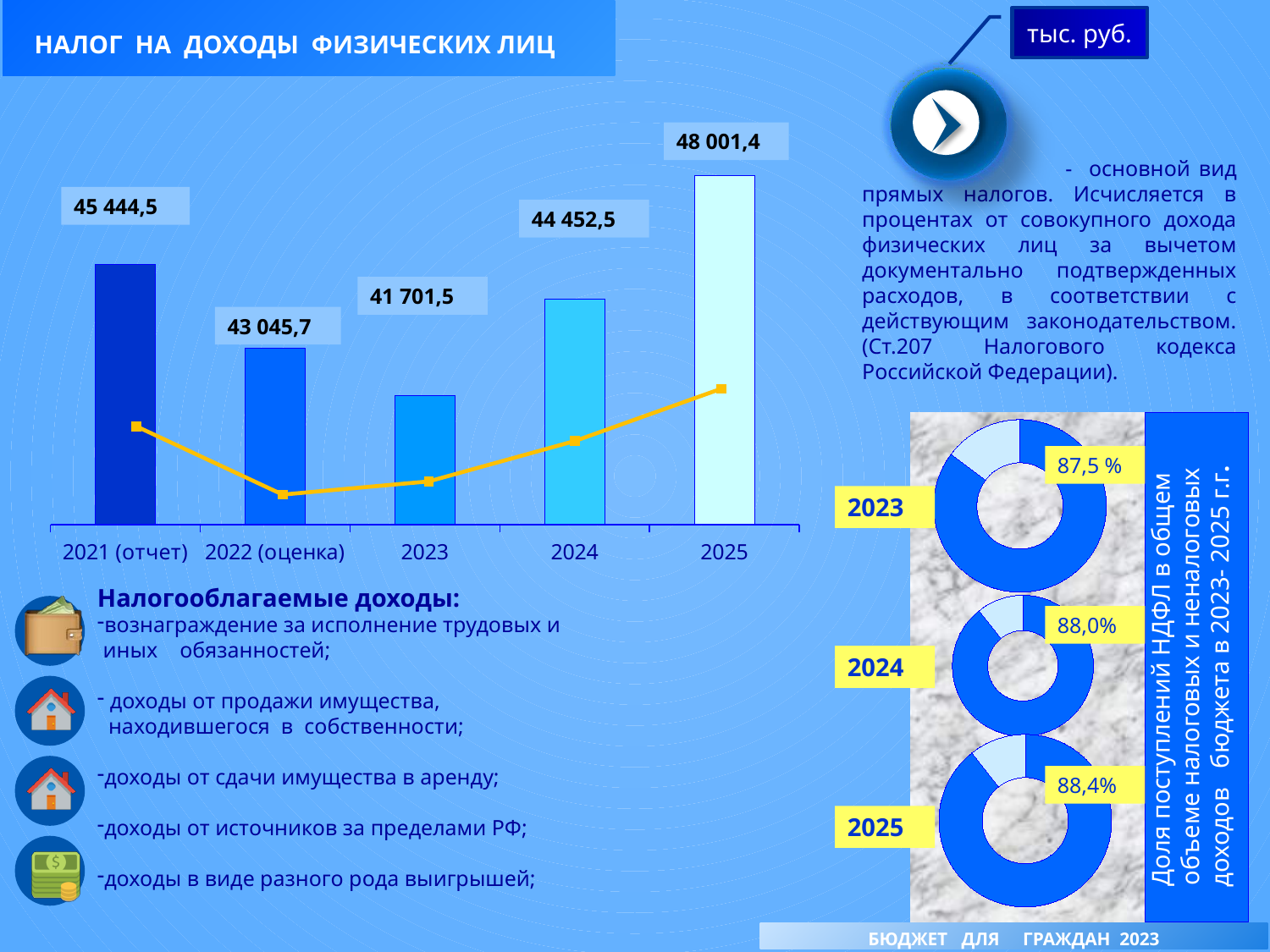
On the bar chart 'НАЛОГ НА ДОХОДЫ ФИЗИЧЕСКИХ ЛИЦ', which is larger: the value for 2021 (отчет) or the value for 2022 (оценка)? 2021 (отчет) On the donut charts on the right of the slide, what share is shown for 2025? 88,4% On the bar chart 'НАЛОГ НА ДОХОДЫ ФИЗИЧЕСКИХ ЛИЦ', what is the difference between the values for 2025 and 2024? 3 548,9 On the bar chart 'НАЛОГ НА ДОХОДЫ ФИЗИЧЕСКИХ ЛИЦ', what is the value for 2025? 48 001,4 On the bar chart 'НАЛОГ НА ДОХОДЫ ФИЗИЧЕСКИХ ЛИЦ', do the values rise or fall from 2023 to 2025? Rise How many years are shown on the bar chart 'НАЛОГ НА ДОХОДЫ ФИЗИЧЕСКИХ ЛИЦ'? 5 On the bar chart 'НАЛОГ НА ДОХОДЫ ФИЗИЧЕСКИХ ЛИЦ', which year has the lowest value? 2023 On the bar chart 'НАЛОГ НА ДОХОДЫ ФИЗИЧЕСКИХ ЛИЦ', what is the value for 2023? 41 701,5 On the bar chart 'НАЛОГ НА ДОХОДЫ ФИЗИЧЕСКИХ ЛИЦ', which year has the highest value? 2025 On the bar chart 'НАЛОГ НА ДОХОДЫ ФИЗИЧЕСКИХ ЛИЦ', what is the value for 2021 (отчет)? 45 444,5 What kind of chart is the chart 'НАЛОГ НА ДОХОДЫ ФИЗИЧЕСКИХ ЛИЦ' on the left of the slide? Bar chart with a line On the donut charts on the right of the slide, what share of tax and non-tax revenues does НДФЛ make up in 2024? 88,0%